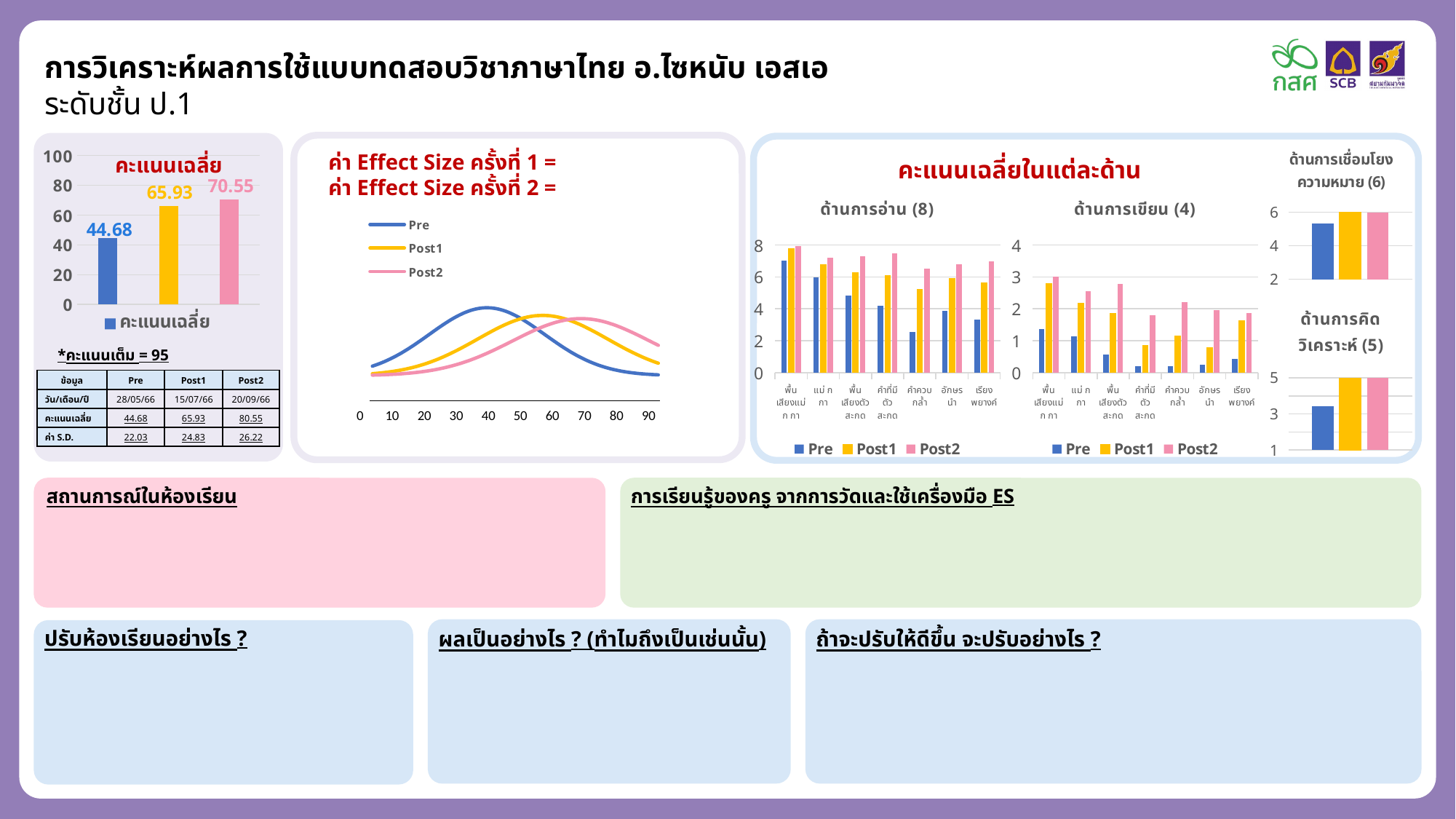
In the คะแนนเฉลี่ย bar chart, what is the value of the first (blue) bar? 44.68 In the คะแนนเฉลี่ย bar chart, do the values rise or fall from left to right? rise In the ด้านการอ่าน (8) chart, is the Pre value for คำควบกล้ำ greater or less than 4? less What kind of chart is the middle chart with the Pre, Post1 and Post2 legend? line chart In the คะแนนเฉลี่ย bar chart, what is the difference between the yellow bar and the blue bar? 21.25 In the คะแนนเฉลี่ย bar chart, what is the value of the yellow bar? 65.93 In the คะแนนเฉลี่ย bar chart, what is the value of the pink bar? 70.55 In the คะแนนเฉลี่ย bar chart, what is the lowest value shown? 44.68 In the คะแนนเฉลี่ย bar chart, how many bars are plotted? 3 How many series does the legend of the middle line chart list? 3 In the ด้านการเขียน (4) chart, is the Post2 value for พื้นเสียงตัวสะกด greater or less than 2? greater In the คะแนนเฉลี่ย bar chart, what is the highest value shown? 70.55